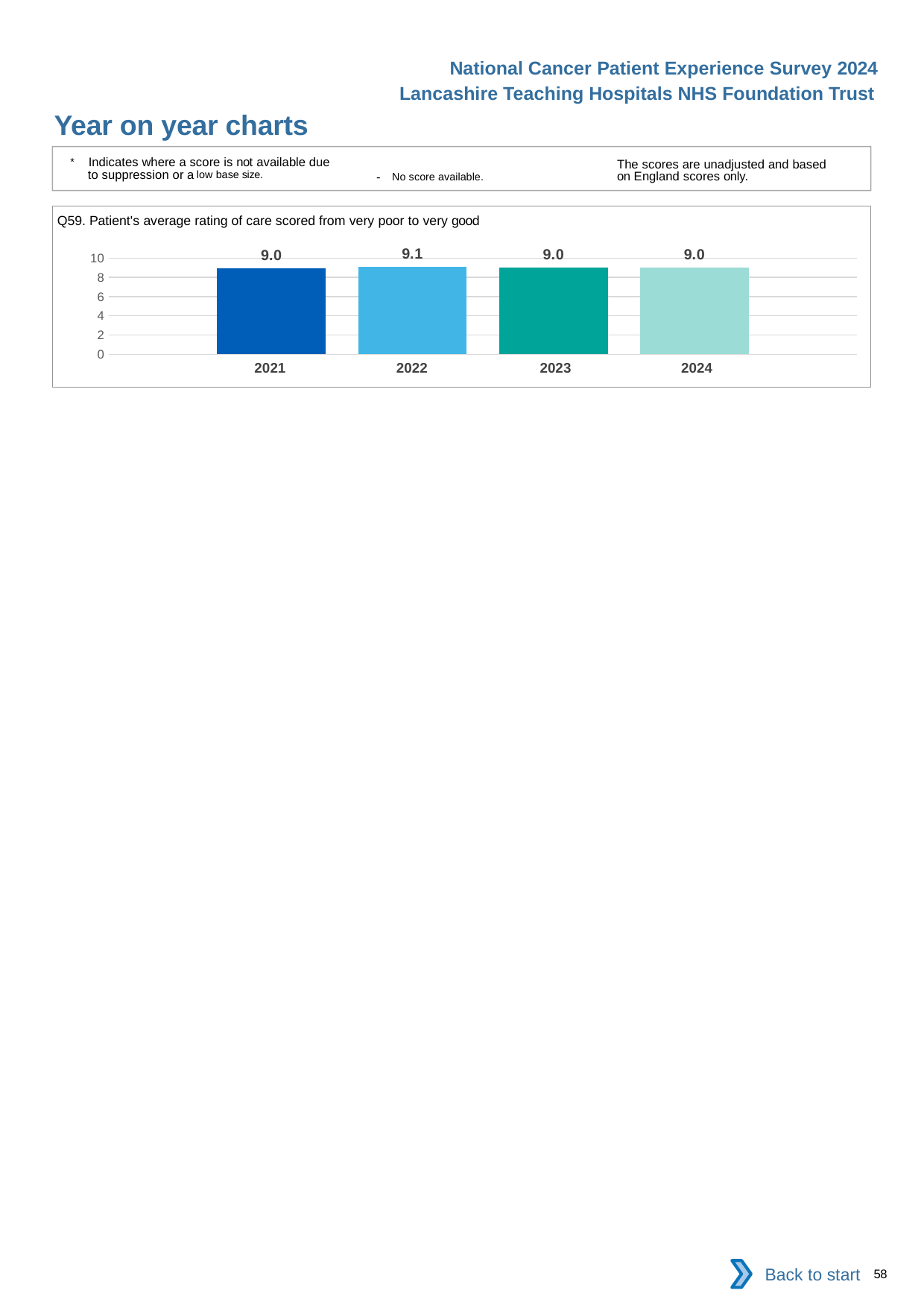
What is the highest value shown on the y axis? 10 What is the difference between the values for 2022 and 2021? 0.1 What kind of chart is shown? bar chart Which is larger, the value for 2022 or the value for 2023? 2022 What is the value for 2024? 9.0 What is the title of the chart? Q59. Patient's average rating of care scored from very poor to very good What is the value for 2021? 9.0 Is the value for 2024 greater or less than 8? greater Which year has the highest value? 2022 What is the value for 2022? 9.1 How many years are shown on the chart? 4 What is the value for 2023? 9.0